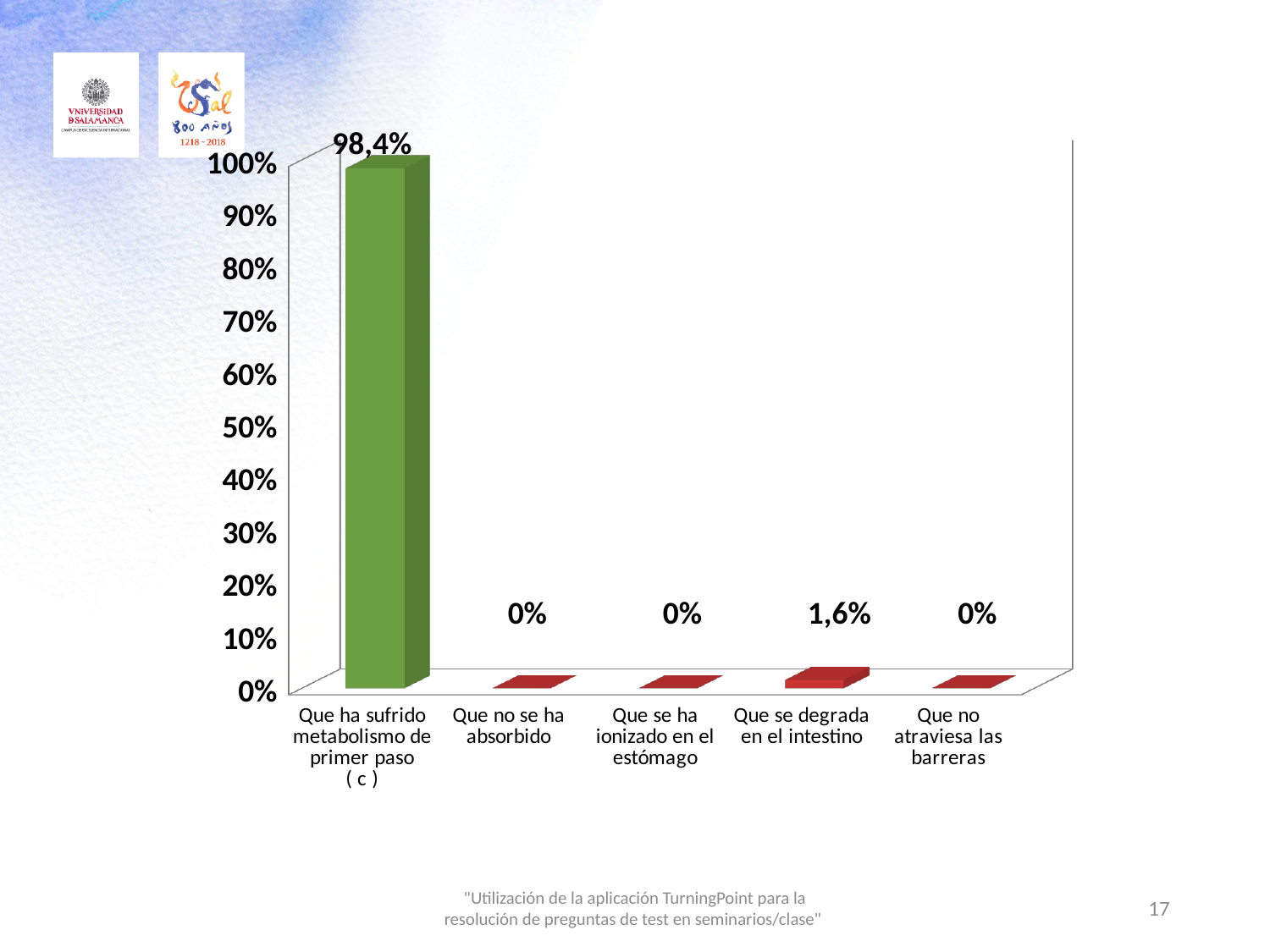
What is the value for "Que no se ha absorbido"? 0% Which is larger, the value for "Que se degrada en el intestino" or the value for "Que se ha ionizado en el estómago"? Que se degrada en el intestino What kind of chart is shown on the slide? bar chart How many categories are shown on the x axis? 5 What is the value for "Que se degrada en el intestino"? 1,6% What is the value for "Que ha sufrido metabolismo de primer paso ( c )"? 98,4% Is the value for "Que ha sufrido metabolismo de primer paso ( c )" greater or less than 90%? greater How many categories have a value of 0%? 3 What is the value for "Que no atraviesa las barreras"? 0% Which category has the highest value? Que ha sufrido metabolismo de primer paso ( c ) What is the difference between the values for "Que ha sufrido metabolismo de primer paso ( c )" and "Que se degrada en el intestino"? 96,8% What colour is the bar for "Que ha sufrido metabolismo de primer paso ( c )"? green